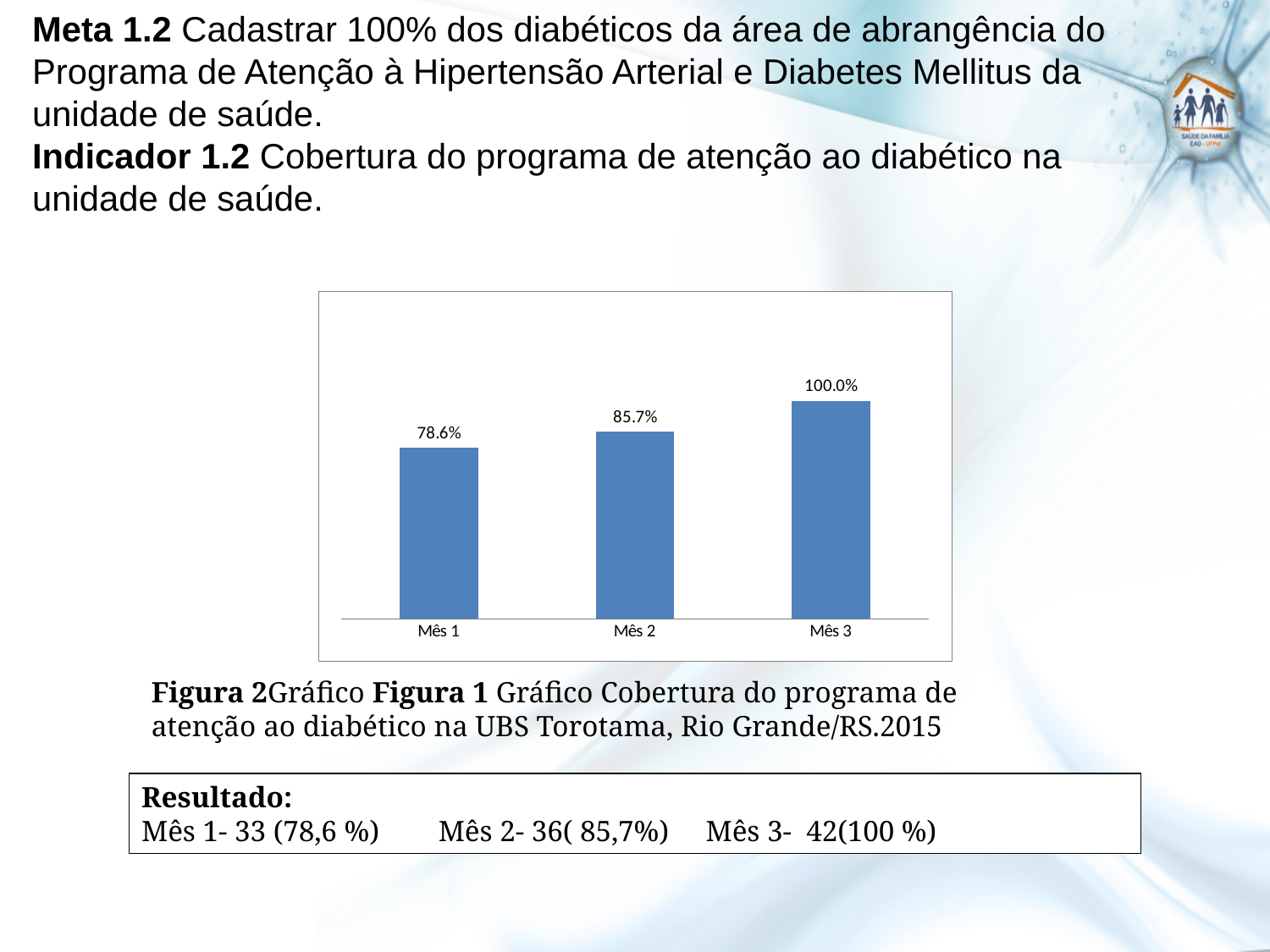
Which month has the lowest value? Mês 1 What is the value for Mês 1? 78.6% What is the value for Mês 2? 85.7% What is the value for Mês 3? 100.0% Which month has the highest value? Mês 3 What kind of chart is shown on the slide? Bar chart Which is larger, the value for Mês 2 or the value for Mês 3? Mês 3 Do the values rise or fall from Mês 1 to Mês 3? Rise What colour are the bars in the chart? Blue What is the difference between the values for Mês 3 and Mês 1? 21.4% How many months are shown on the chart? 3 What is the difference between the values for Mês 2 and Mês 1? 7.1%